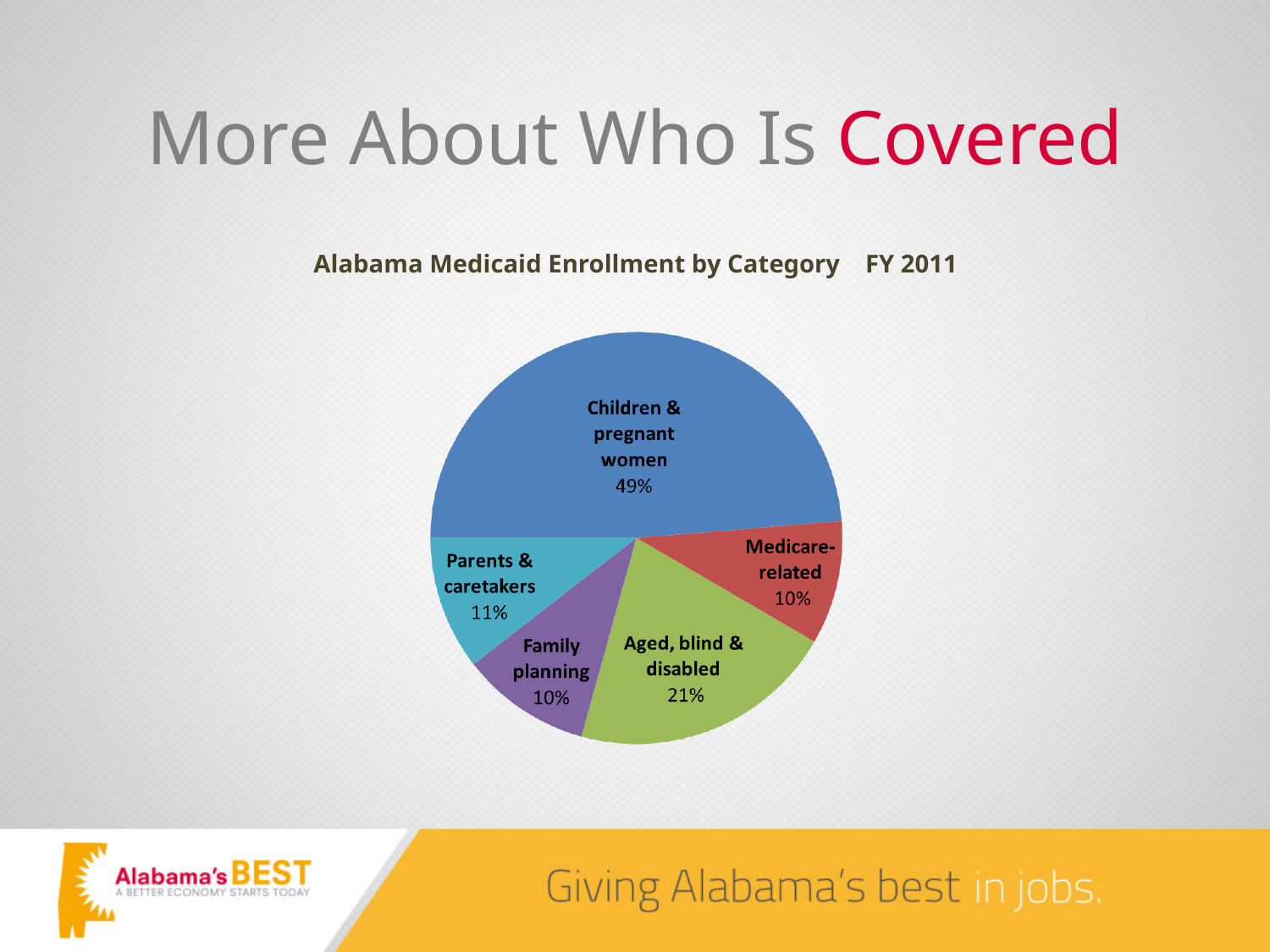
What colour is the Aged, blind & disabled slice? Green What share of Alabama Medicaid enrollment is Children & pregnant women? 49% What share of enrollment is Medicare-related? 10% What share of enrollment is Family planning? 10% What share of enrollment is Parents & caretakers? 11% What is the difference in percentage points between Children & pregnant women and Aged, blind & disabled? 28 How many categories are shown in the pie chart? 5 What kind of chart is shown on the slide? Pie chart What is the title of the chart? Alabama Medicaid Enrollment by Category FY 2011 Which is larger, the share for Parents & caretakers or the share for Family planning? Parents & caretakers Which category has the largest share of enrollment? Children & pregnant women What share of enrollment is Aged, blind & disabled? 21%